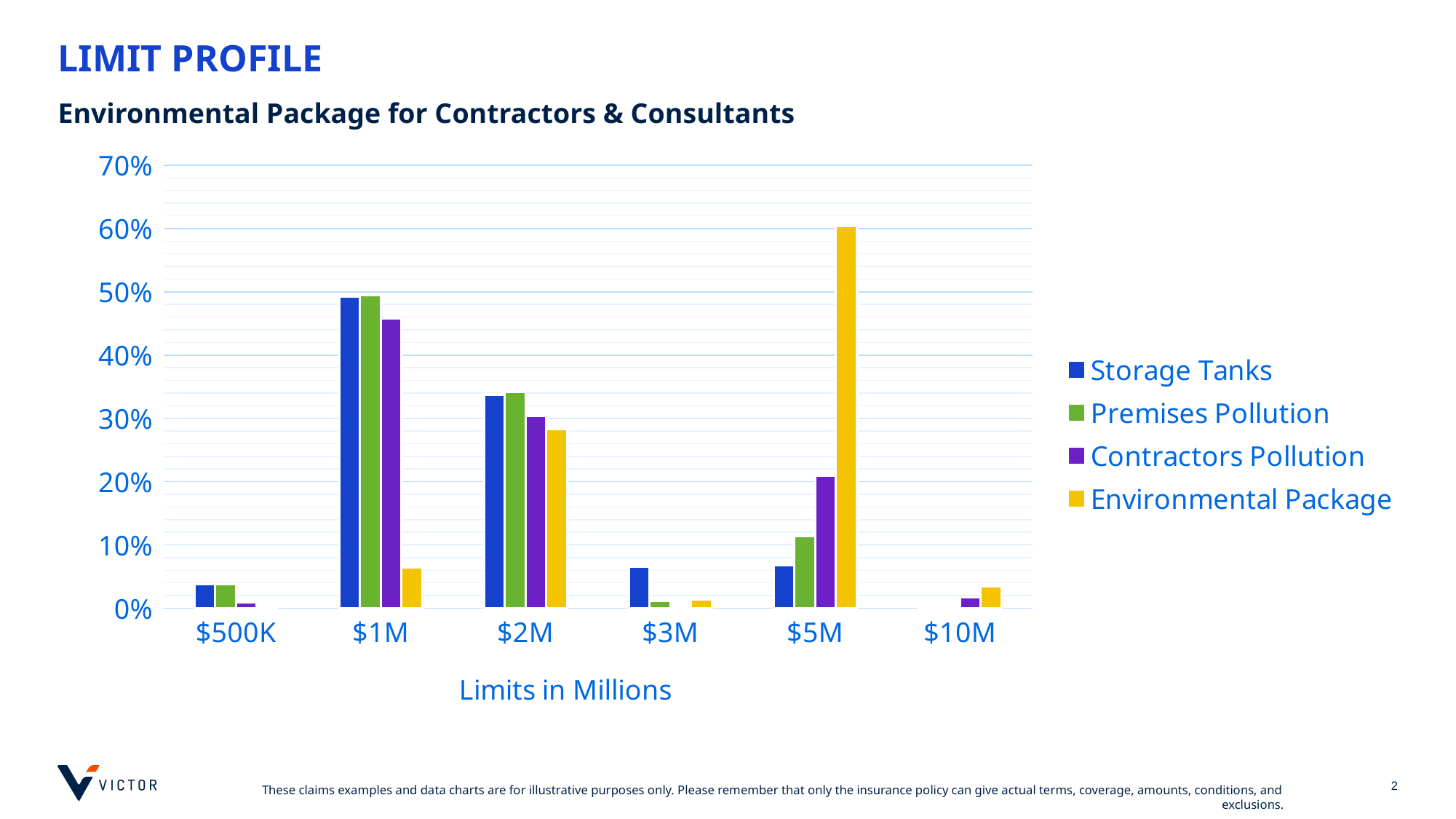
How many series does the legend list? 4 Is the value for Contractors Pollution at $5M greater or less than 30%? less At which limit is the Environmental Package bar highest? $5M What is the title of the x axis? Limits in Millions At which limit is the Contractors Pollution bar highest? $1M Is the value for Environmental Package at $1M greater or less than 10%? less Is the value for Storage Tanks at $1M greater or less than 40%? greater How many limit categories are shown on the x axis? 6 At the $2M limit, which is larger: Storage Tanks or Environmental Package? Storage Tanks What kind of chart is shown on the slide? bar chart At the $5M limit, which is larger: Environmental Package or Storage Tanks? Environmental Package